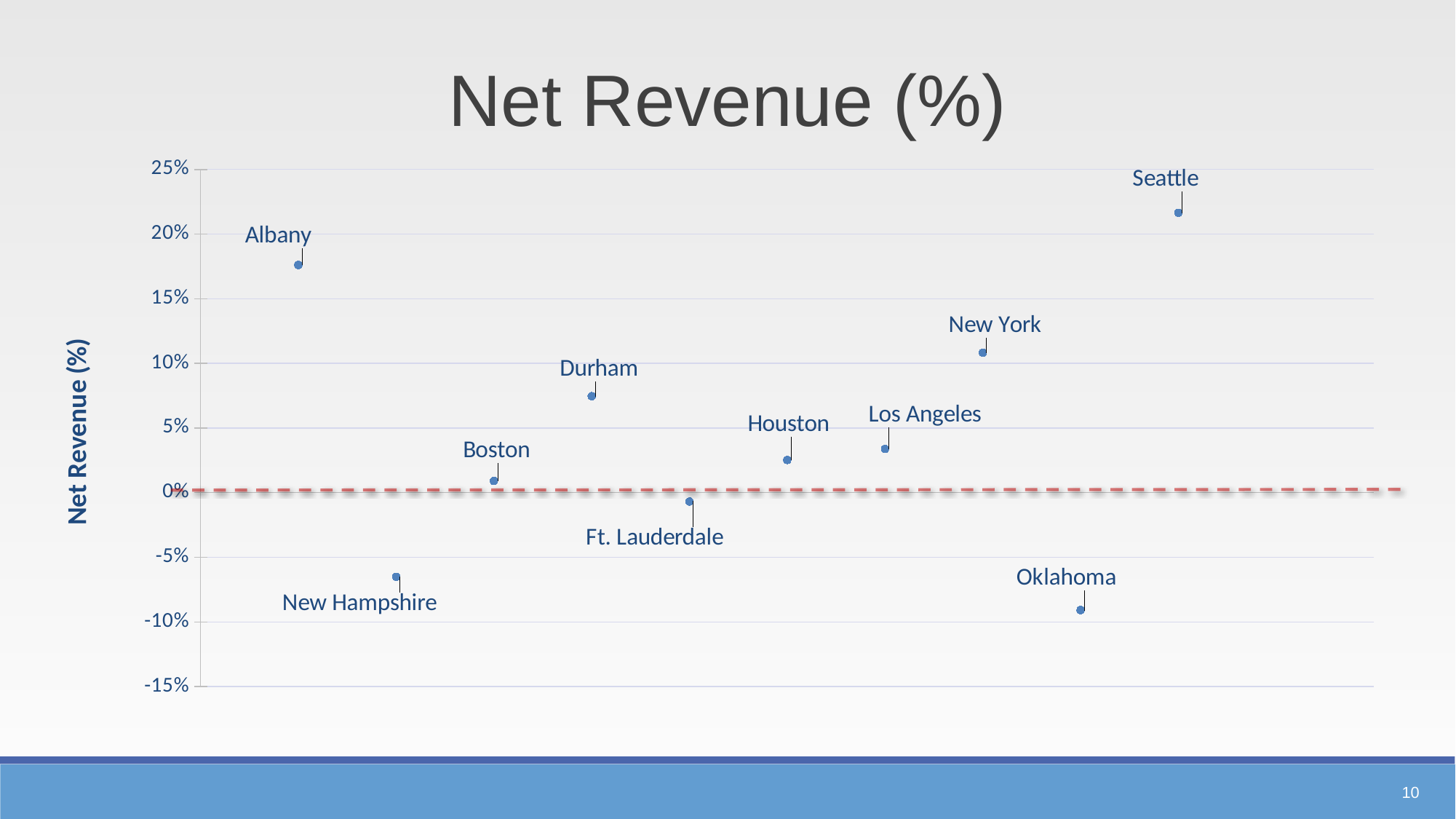
Which has a higher net revenue, New York or Los Angeles? New York Which city has the lowest net revenue? Oklahoma Which has a higher net revenue, Albany or Durham? Albany Is the value for Oklahoma greater or less than -5%? less How many cities are plotted on the chart? 10 Is the value for Durham greater or less than 5%? greater Which city has the highest net revenue? Seattle What is the title of the chart? Net Revenue (%) What kind of chart is shown on the slide? scatter chart Is the value for Seattle greater or less than 20%? greater At what value is the red dashed horizontal line drawn? 0%